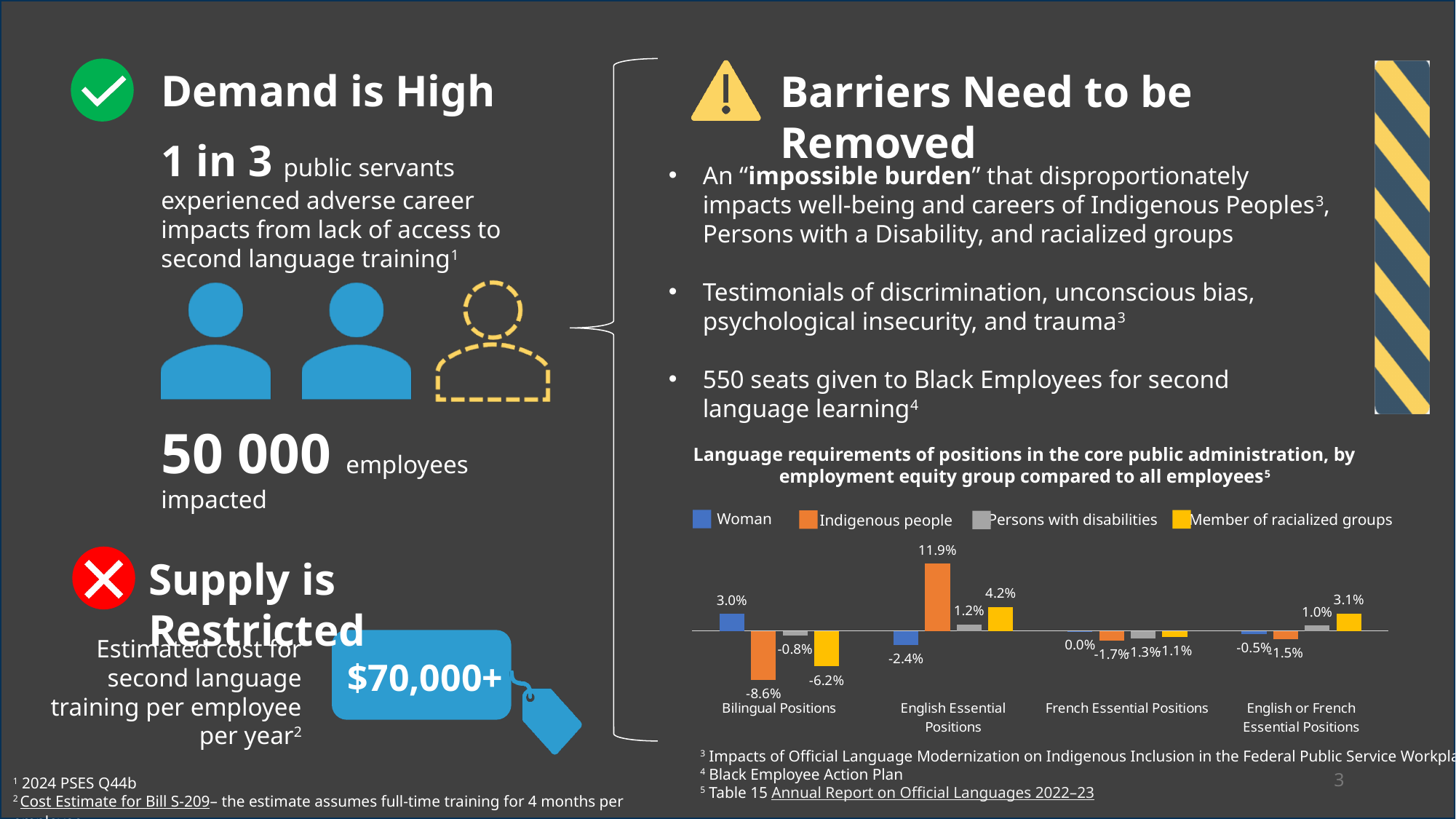
How many position categories are shown on the x axis of the chart? 4 Which colour represents Indigenous people in the chart? Orange What is the value for Indigenous people in English Essential Positions? 11.9% What is the value for Woman in Bilingual Positions? 3.0% Which employment equity group has the highest value in English Essential Positions? Indigenous people What is the value for Persons with disabilities in English or French Essential Positions? 1.0% What kind of chart is shown on the slide? Bar chart How many series does the chart legend list? 4 What is the difference between the Indigenous people value and the Member of racialized groups value in English Essential Positions? 7.7% Which is larger in English or French Essential Positions: the value for Member of racialized groups or the value for Persons with disabilities? Member of racialized groups What is the value for Member of racialized groups in Bilingual Positions? -6.2% Which employment equity group has the lowest value in Bilingual Positions? Indigenous people